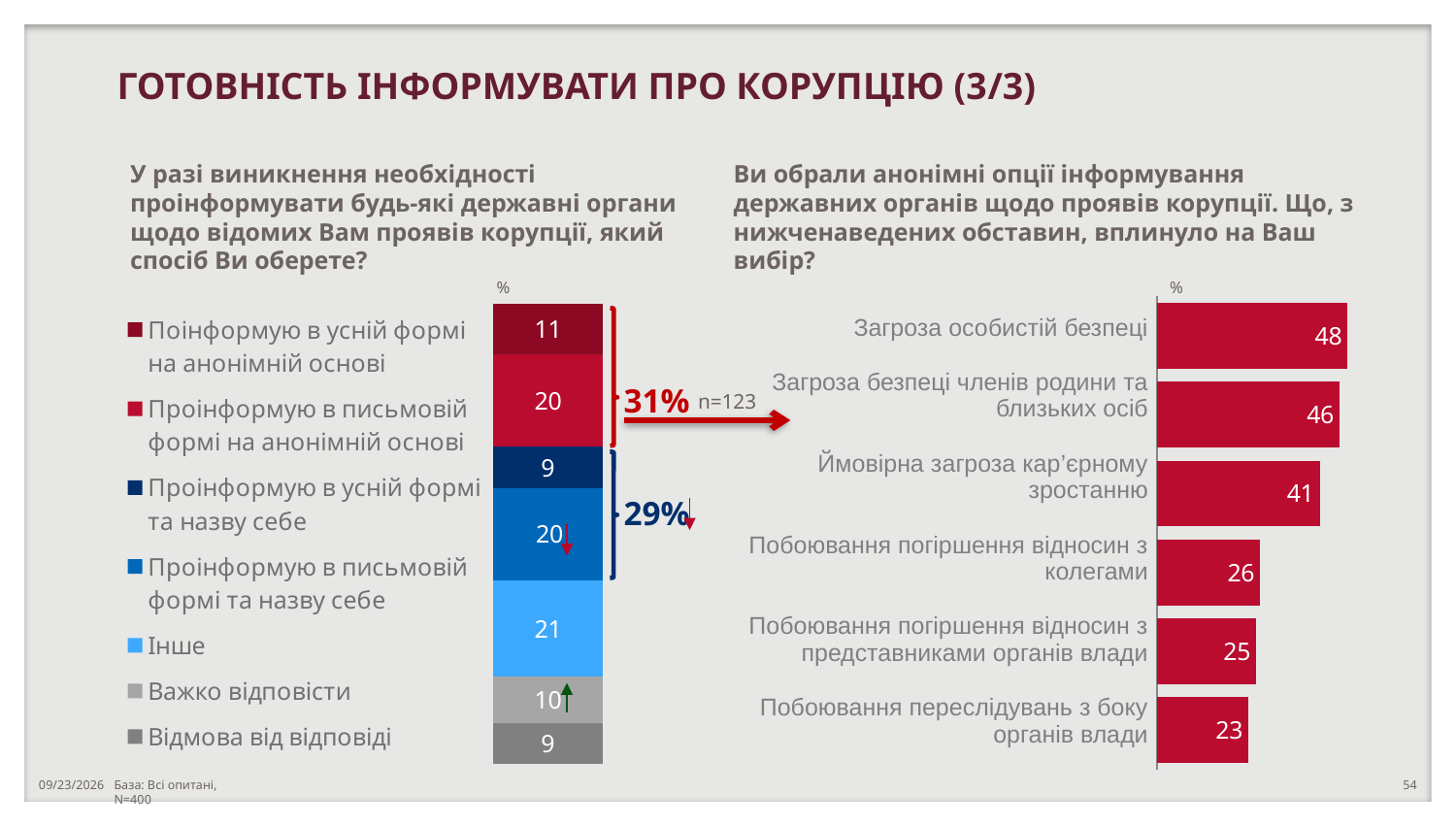
In the right-hand bar chart, what is the value for «Побоювання переслідувань з боку органів влади»? 23 In the right-hand bar chart, which category has the lowest value? Побоювання переслідувань з боку органів влади In the left-hand stacked bar chart, what is the value for «Поінформую в усній формі на анонімній основі»? 11 What type of chart is shown on the right-hand side of the slide? bar chart In the right-hand bar chart, which category has the highest value? Загроза особистій безпеці In the left-hand stacked bar chart, what is the total of the two anonymous options («Поінформую в усній формі на анонімній основі» and «Проінформую в письмовій формі на анонімній основі»)? 31% In the left-hand stacked bar chart, how many series does the legend list? 7 In the right-hand bar chart, do the values rise or fall from top to bottom? fall In the right-hand bar chart, what is the difference between «Загроза особистій безпеці» and «Ймовірна загроза кар’єрному зростанню»? 7 In the right-hand bar chart, how many categories are shown? 6 In the right-hand bar chart, what is the value for «Загроза особистій безпеці»? 48 In the left-hand stacked bar chart, what is the value for «Інше»? 21